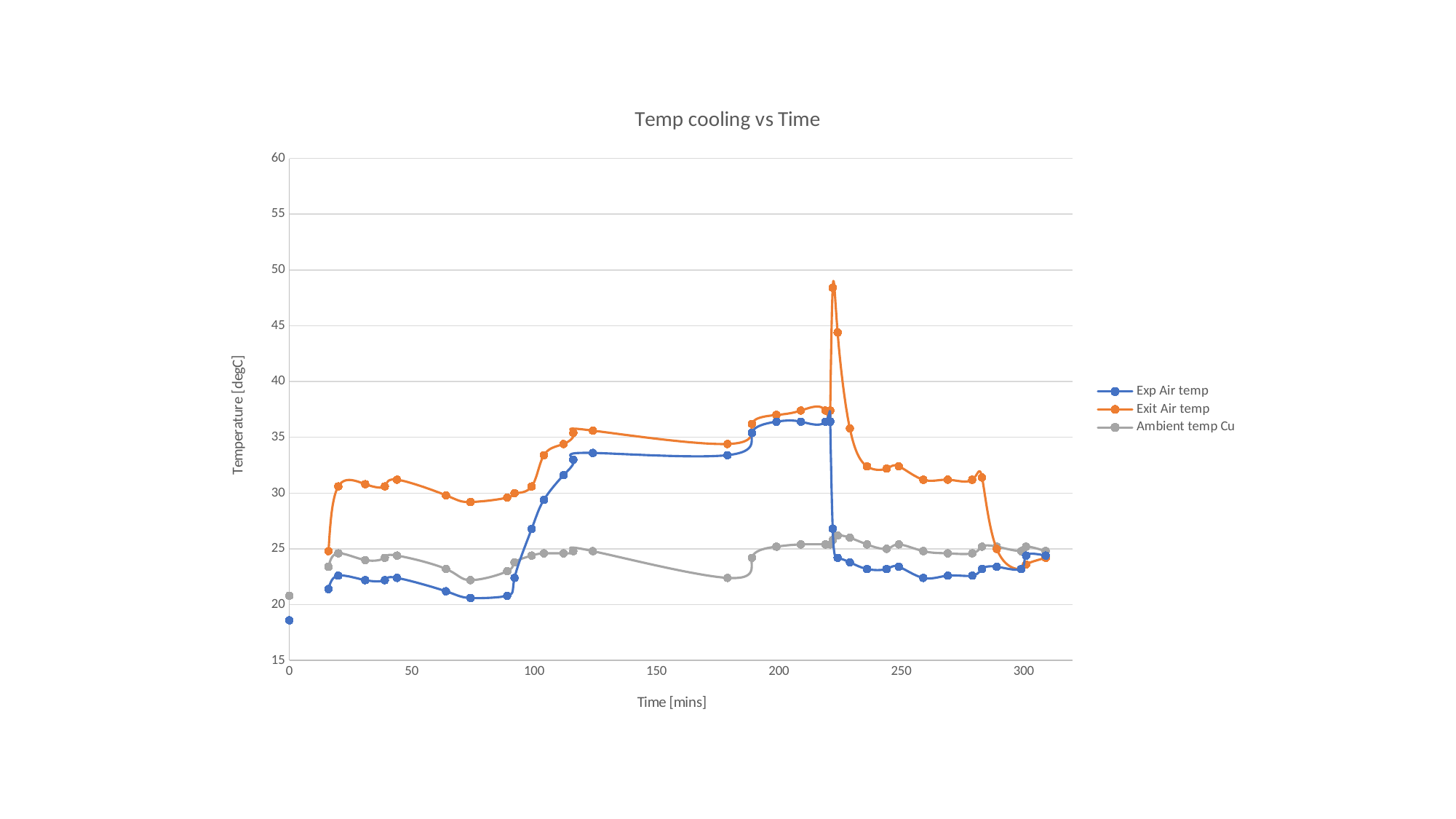
At time 0, which is higher, Exp Air temp or Ambient temp Cu? Ambient temp Cu What kind of chart is shown on the slide? line chart What is the title of the chart? Temp cooling vs Time Which series reaches the highest temperature anywhere on the chart? Exit Air temp Is the highest value of Ambient temp Cu greater or less than 30? less How many series does the legend list? 3 What is the label on the vertical axis? Temperature [degC] Does the Exp Air temp rise or fall between about 90 and 120 minutes? rise Is the Exp Air temp value at time 0 greater or less than 20? less Is the peak value of Exit Air temp greater or less than 45? greater